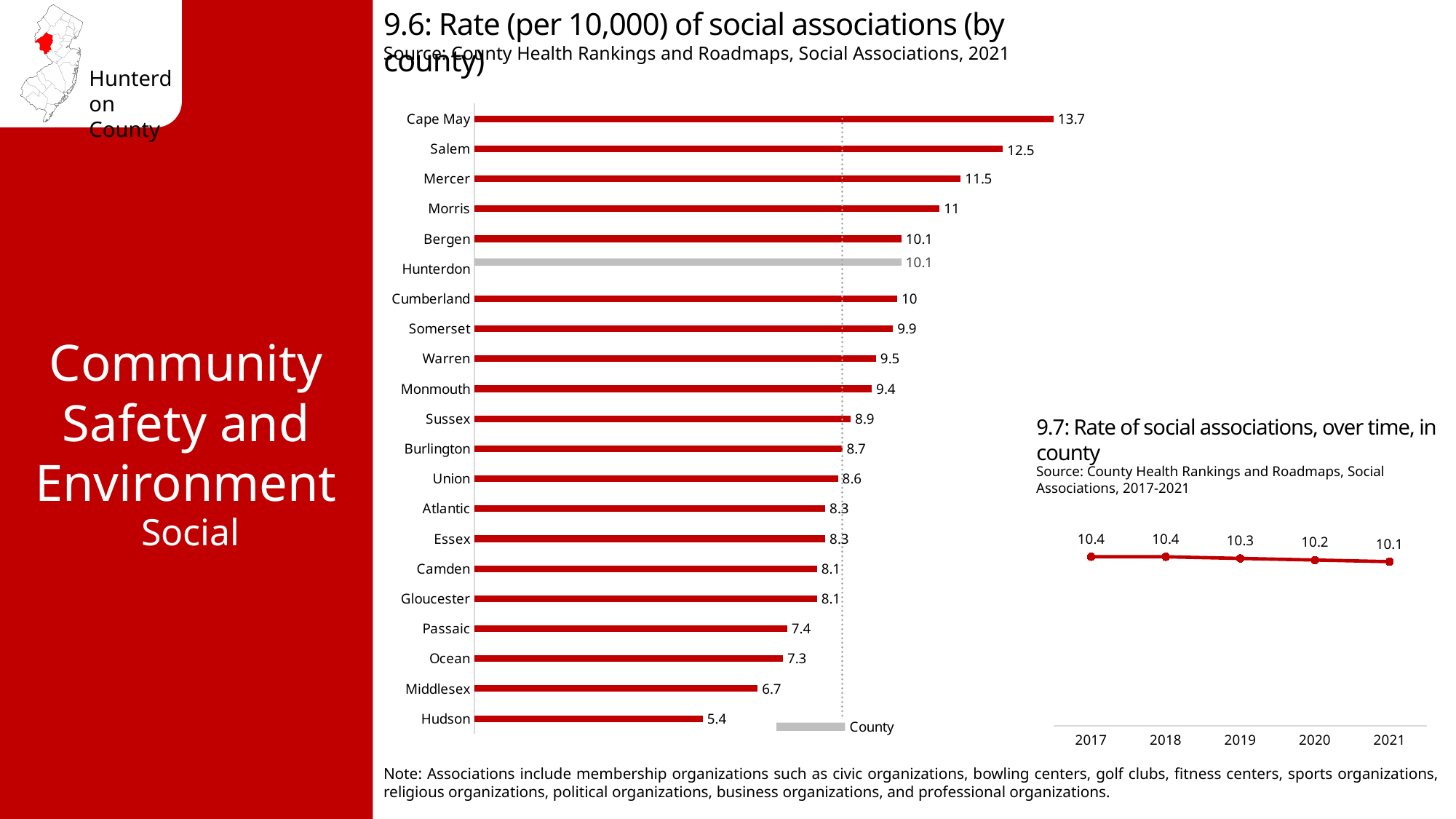
In the chart '9.6: Rate (per 10,000) of social associations (by county)', which has a higher rate, Mercer or Morris? Mercer In the chart '9.7: Rate of social associations, over time, in county', do the values rise or fall from 2017 to 2021? Fall In the chart '9.7: Rate of social associations, over time, in county', how many years are plotted? 5 In the chart '9.6: Rate (per 10,000) of social associations (by county)', what is the value for Hunterdon? 10.1 In the chart '9.6: Rate (per 10,000) of social associations (by county)', which county has the lowest rate? Hudson In the chart '9.6: Rate (per 10,000) of social associations (by county)', what is the value for Cape May? 13.7 In the chart '9.7: Rate of social associations, over time, in county', what is the value for 2019? 10.3 What kind of chart is '9.6: Rate (per 10,000) of social associations (by county)'? Bar chart In the chart '9.6: Rate (per 10,000) of social associations (by county)', what is the difference between the values for Salem and Middlesex? 5.8 In the chart '9.6: Rate (per 10,000) of social associations (by county)', what label does the legend give to the grey bar? County In the chart '9.6: Rate (per 10,000) of social associations (by county)', which county has the highest rate? Cape May In the chart '9.6: Rate (per 10,000) of social associations (by county)', how many counties are shown? 21